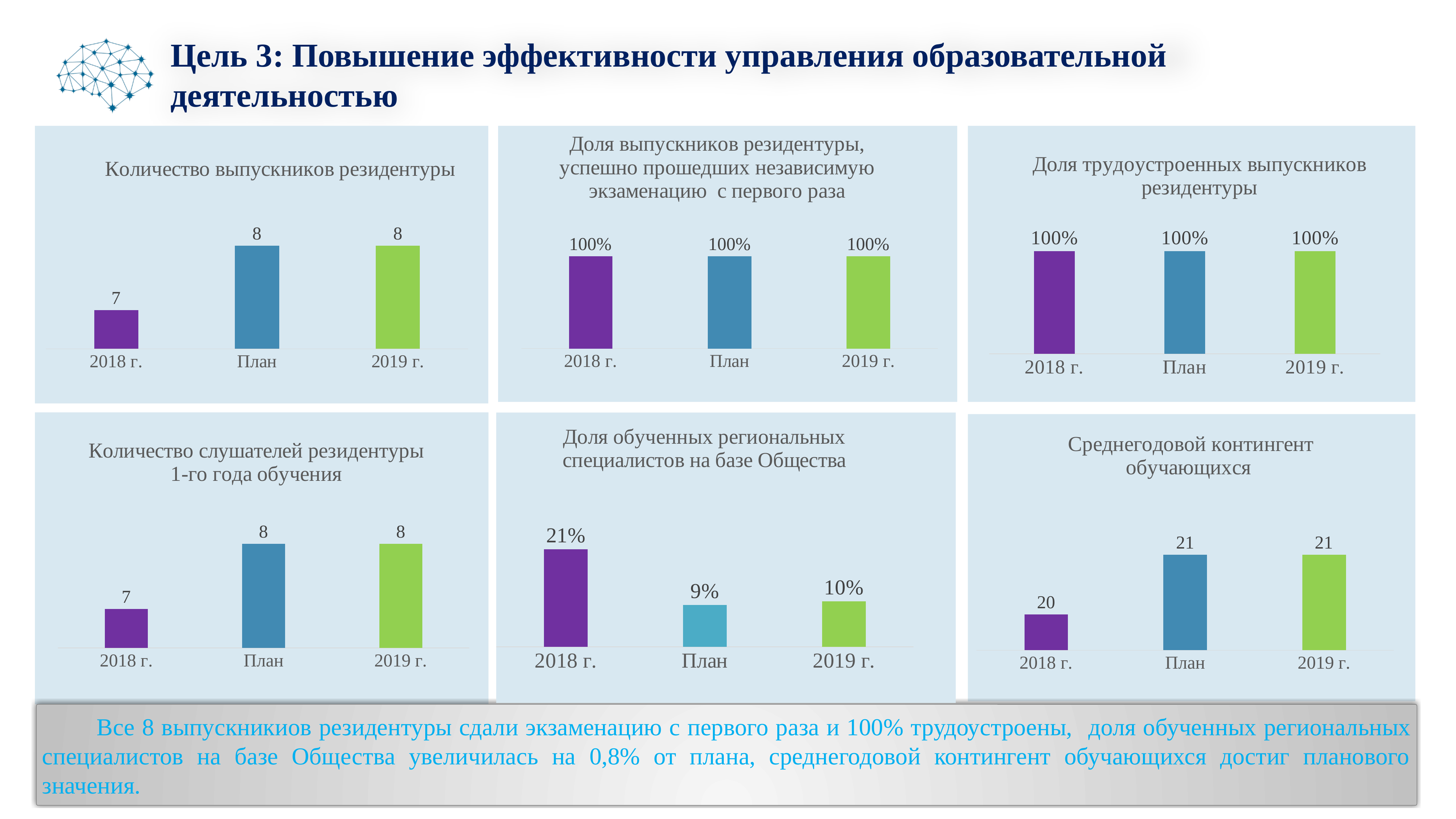
In the chart titled "Доля обученных региональных специалистов на базе Общества", which category has the highest value? 2018 г. In the chart titled "Доля обученных региональных специалистов на базе Общества", which category has the lowest value? План In the chart titled "Доля трудоустроенных выпускников резидентуры", what is the value for 2018 г.? 100% How many categories are shown in the chart titled "Среднегодовой контингент обучающихся"? 3 In the chart titled "Количество выпускников резидентуры", what is the value for 2018 г.? 7 In the chart titled "Количество слушателей резидентуры 1-го года обучения", what is the difference between the План value and the 2018 г. value? 1 What type of chart is the chart titled "Количество выпускников резидентуры"? Bar chart In the chart titled "Среднегодовой контингент обучающихся", which is larger: the value for План or the value for 2018 г.? План In the chart titled "Доля обученных региональных специалистов на базе Общества", what is the difference between the 2018 г. value and the 2019 г. value? 11% In the chart titled "Доля выпускников резидентуры, успешно прошедших независимую экзаменацию с первого раза", what is the value for 2019 г.? 100% In the chart titled "Среднегодовой контингент обучающихся", what is the value for 2018 г.? 20 In the chart titled "Количество выпускников резидентуры", what is the value for План? 8